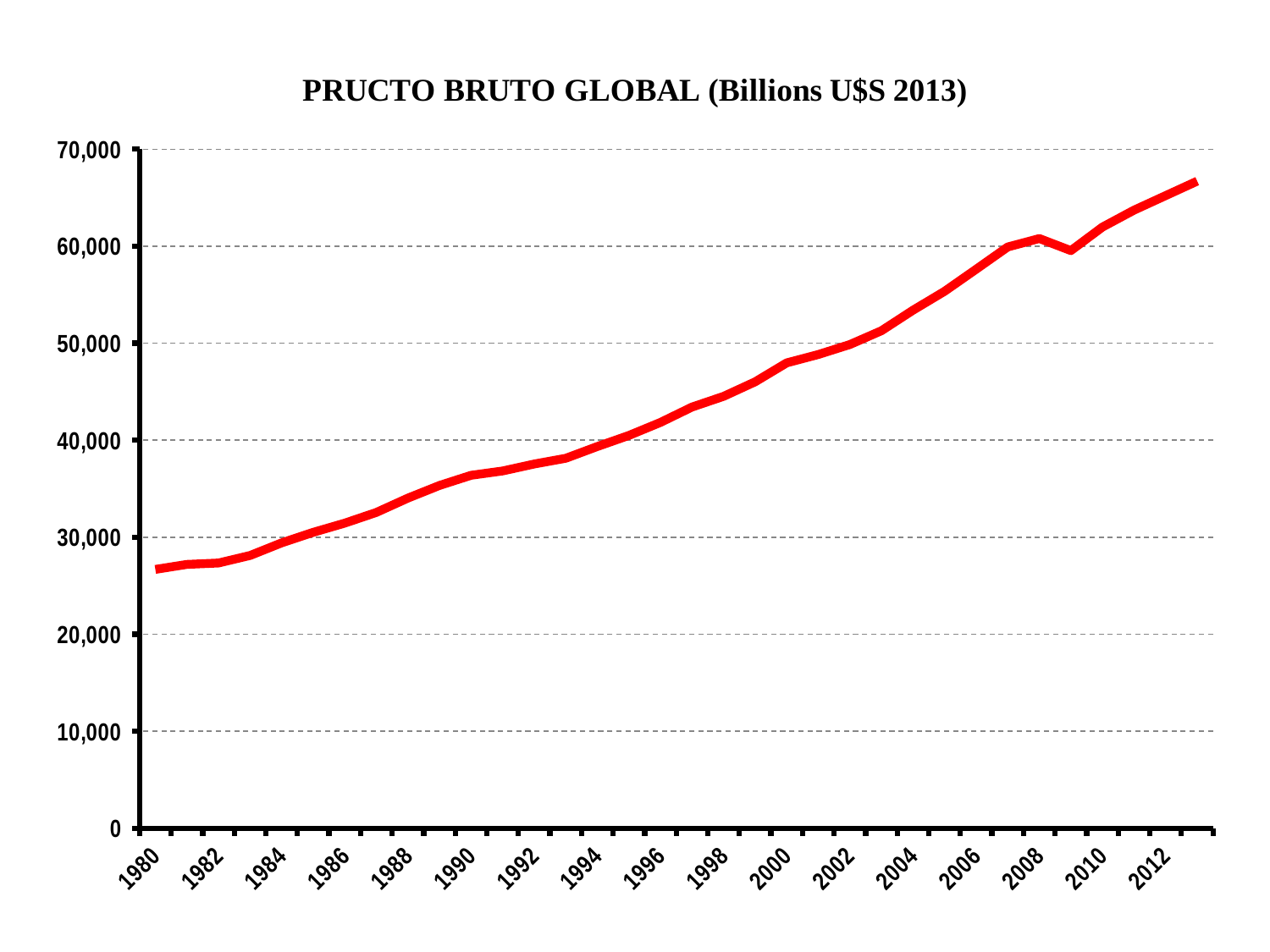
Is the value for 1996 greater or less than 40,000? greater Overall, do the values rise or fall from 1980 to the end of the series? rise Is the value for 1980 greater or less than 30,000? less Is the value for 2012 greater or less than 60,000? greater What colour is the line in the chart? red What is the title of the chart? PRUCTO BRUTO GLOBAL (Billions U$S 2013) Which is larger, the value for 1980 or the value for 2012? 2012 What kind of chart is shown on the slide? line chart Which year has the lowest value on the chart? 1980